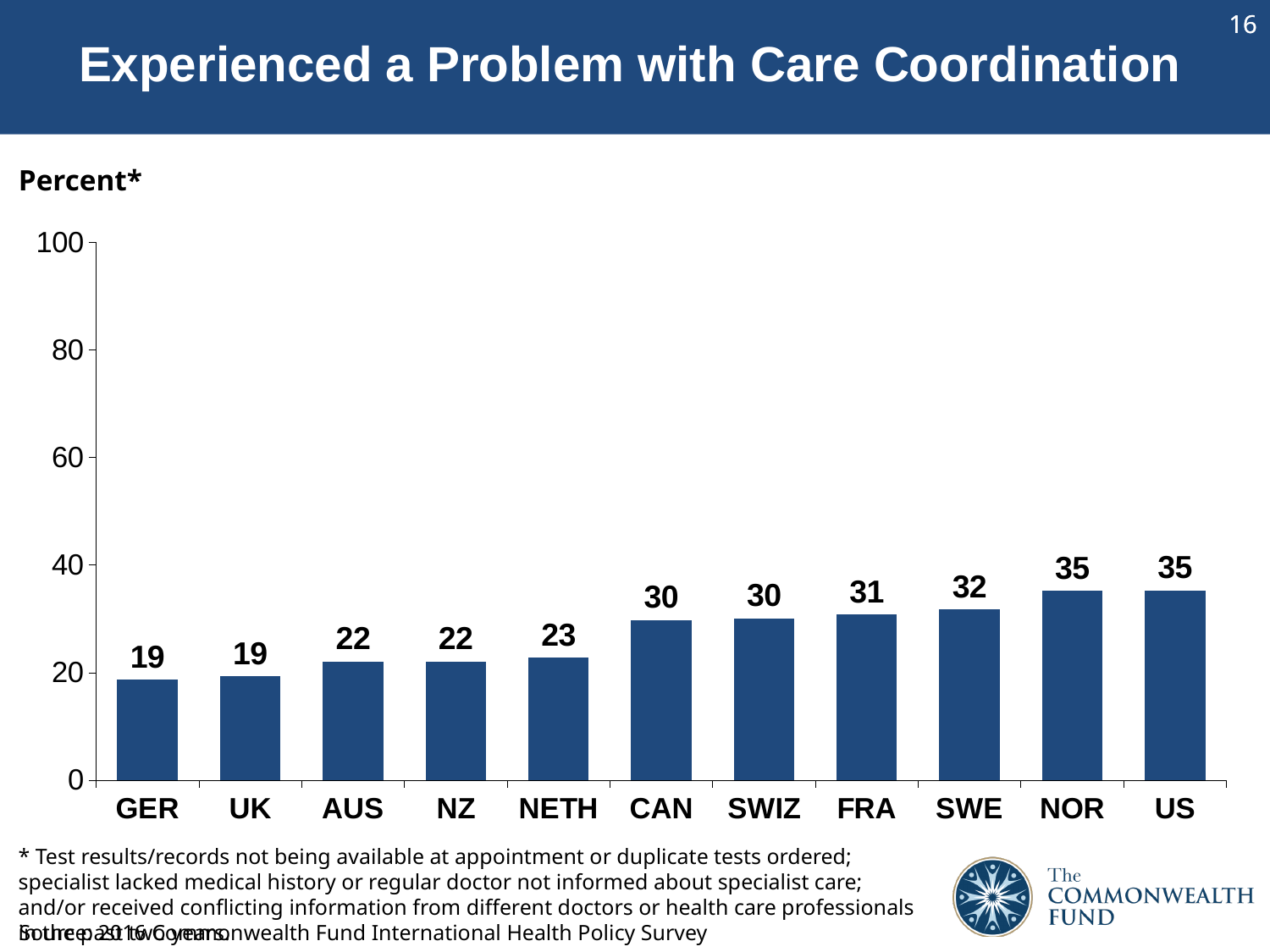
What is the value for NETH? 23 Which countries have the lowest value? GER and UK Which countries have the highest value? NOR and US What kind of chart is shown on the slide? bar chart Is the value for SWE greater or less than 40? less What is the value for GER? 19 What is the difference between the values for FRA and AUS? 9 How many countries are shown on the chart? 11 What is the difference between the values for US and GER? 16 What is the value for SWE? 32 Do the values rise or fall from left to right along the x axis? rise Which is larger, the value for CAN or the value for NZ? CAN